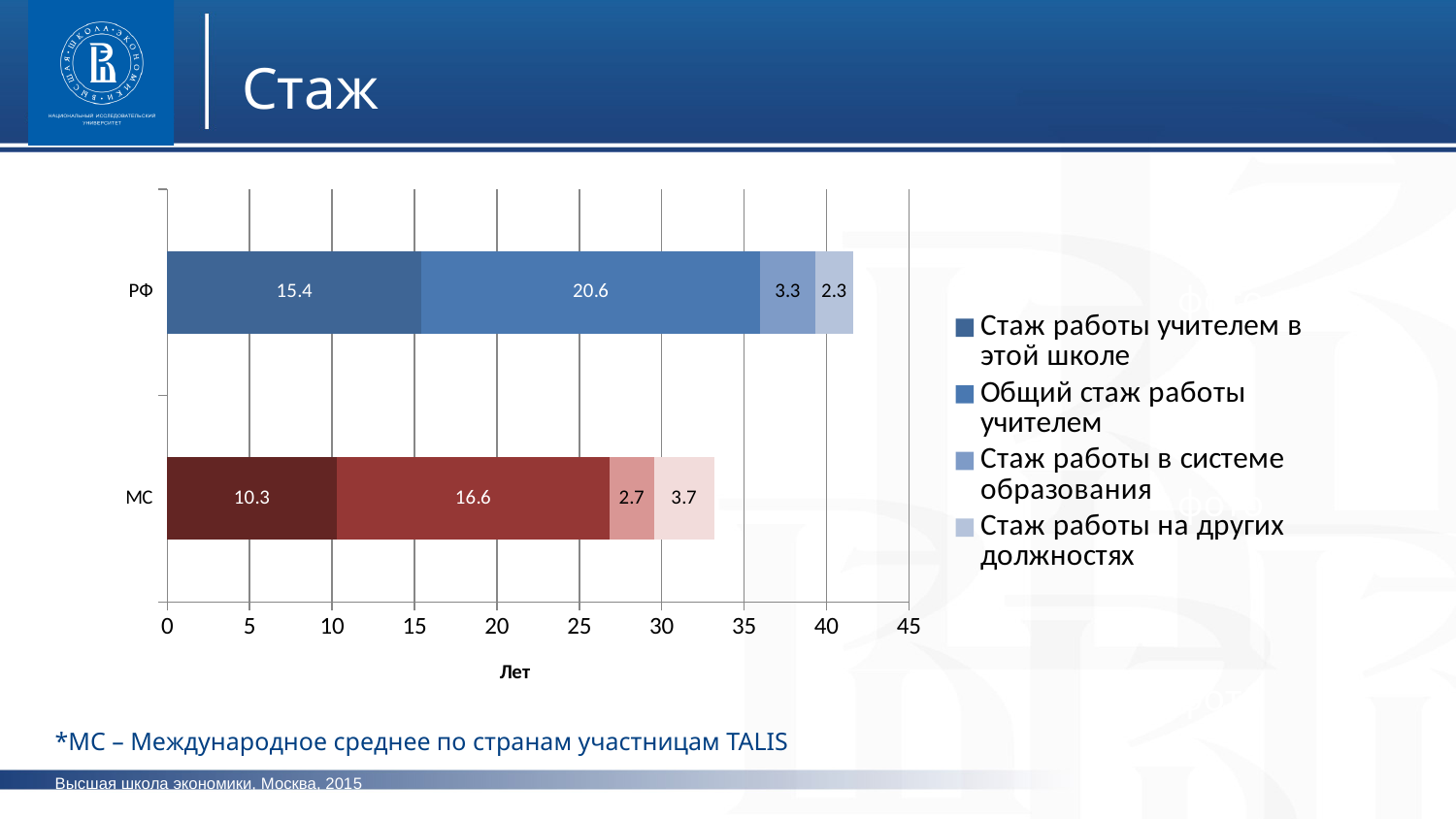
What is the total of the stacked bar for МС? 33.3 Which category has the larger value for "Стаж работы на других должностях", РФ or МС? МС What is the value of "Стаж работы на других должностях" for РФ? 2.3 What type of chart is shown on the slide? Stacked bar chart What is the value of "Стаж работы в системе образования" for МС? 2.7 How many categories are plotted on the chart? 2 What is the total of the stacked bar for РФ? 41.6 What is the label of the x axis? Лет What is the value of "Общий стаж работы учителем" for МС? 16.6 How many series does the legend list? 4 What is the value of "Стаж работы учителем в этой школе" for РФ? 15.4 What is the difference between the "Общий стаж работы учителем" values for РФ and МС? 4.0